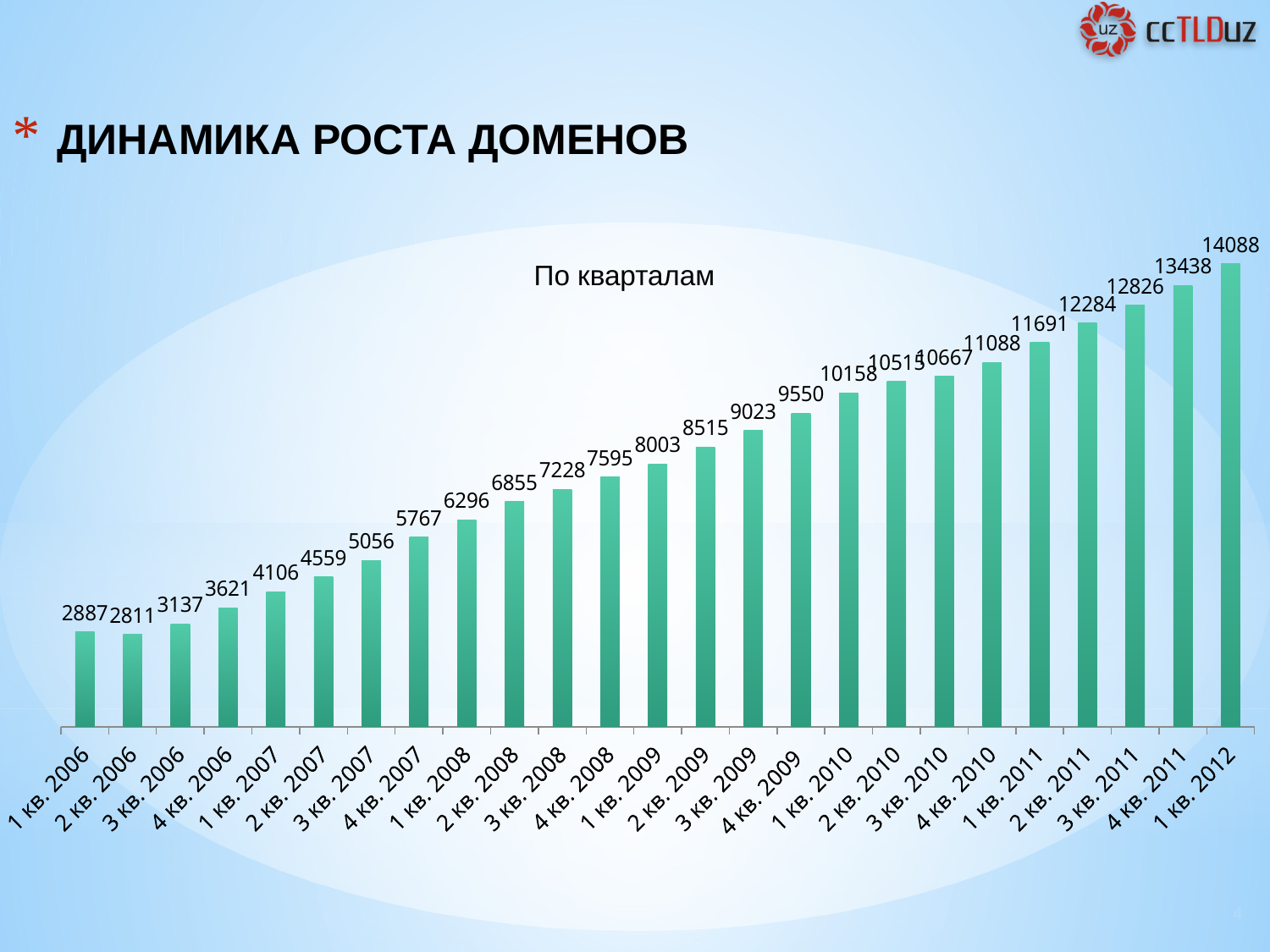
Which quarter has the highest value? 1 кв. 2012 What is the difference between the values for 1 кв. 2006 and 2 кв. 2006? 76 Do the values generally rise or fall from 1 кв. 2006 to 1 кв. 2012? rise What is the title of the chart? По кварталам Which quarter has the lowest value? 2 кв. 2006 What is the difference between the values for 1 кв. 2012 and 4 кв. 2011? 650 What is the value for 4 кв. 2010? 11088 What is the value for 1 кв. 2012? 14088 What kind of chart is shown on the slide? bar chart Which is larger, the value for 4 кв. 2009 or the value for 1 кв. 2010? 1 кв. 2010 How many quarters are shown on the chart? 25 What is the value for 3 кв. 2008? 7228